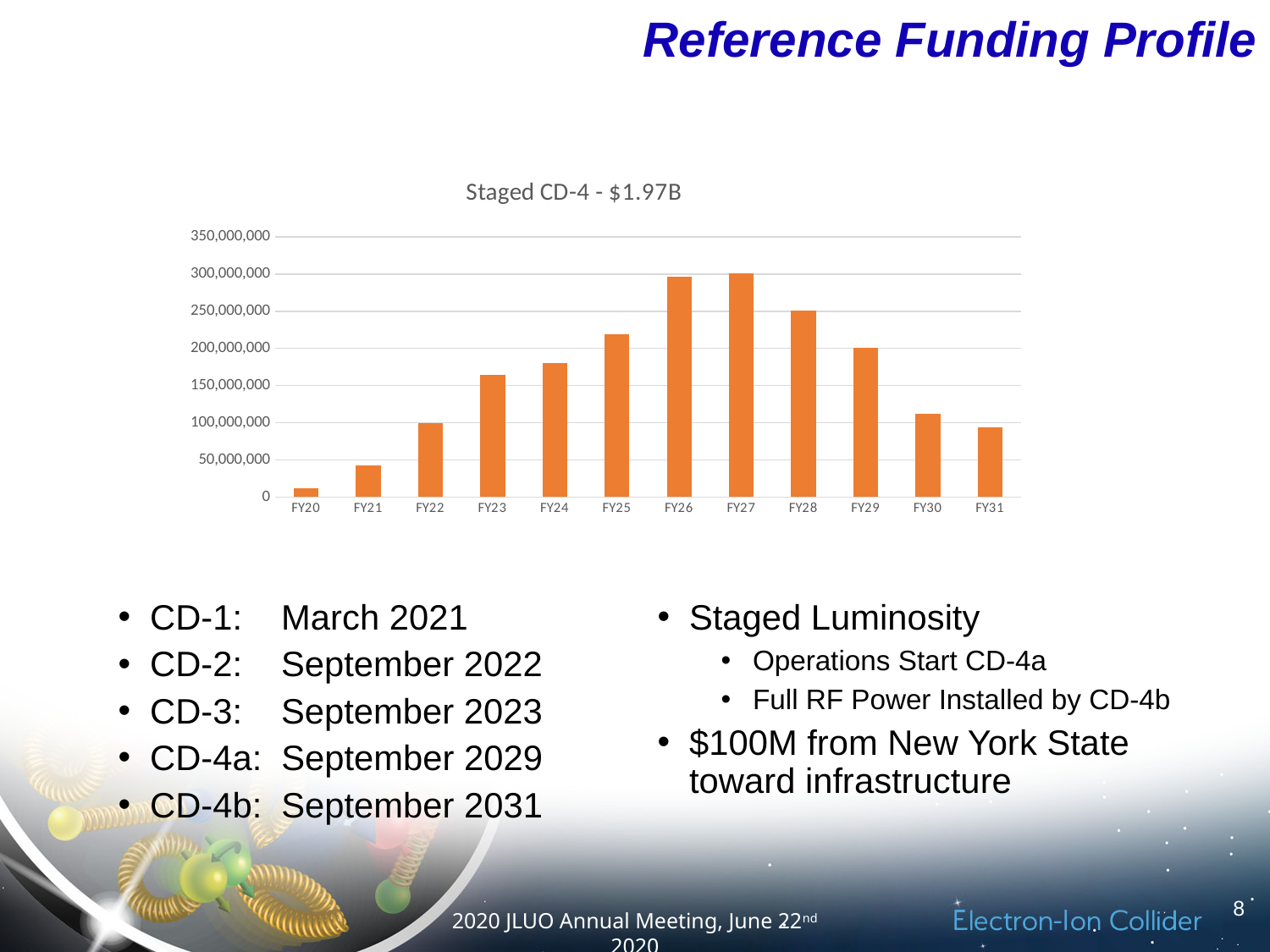
Is the value for FY28 greater or less than 200,000,000? greater What kind of chart is shown on the slide? bar chart Is the value for FY23 greater or less than 150,000,000? greater How many fiscal years are plotted on the x axis of the chart? 12 Is the value for FY21 greater or less than 50,000,000? less Do the values rise or fall from FY27 to FY31? fall Which has the larger value, FY28 or FY30? FY28 Which fiscal year has the lowest funding value in the chart? FY20 What is the title of the chart? Staged CD-4 - $1.97B Which has the larger value, FY26 or FY24? FY26